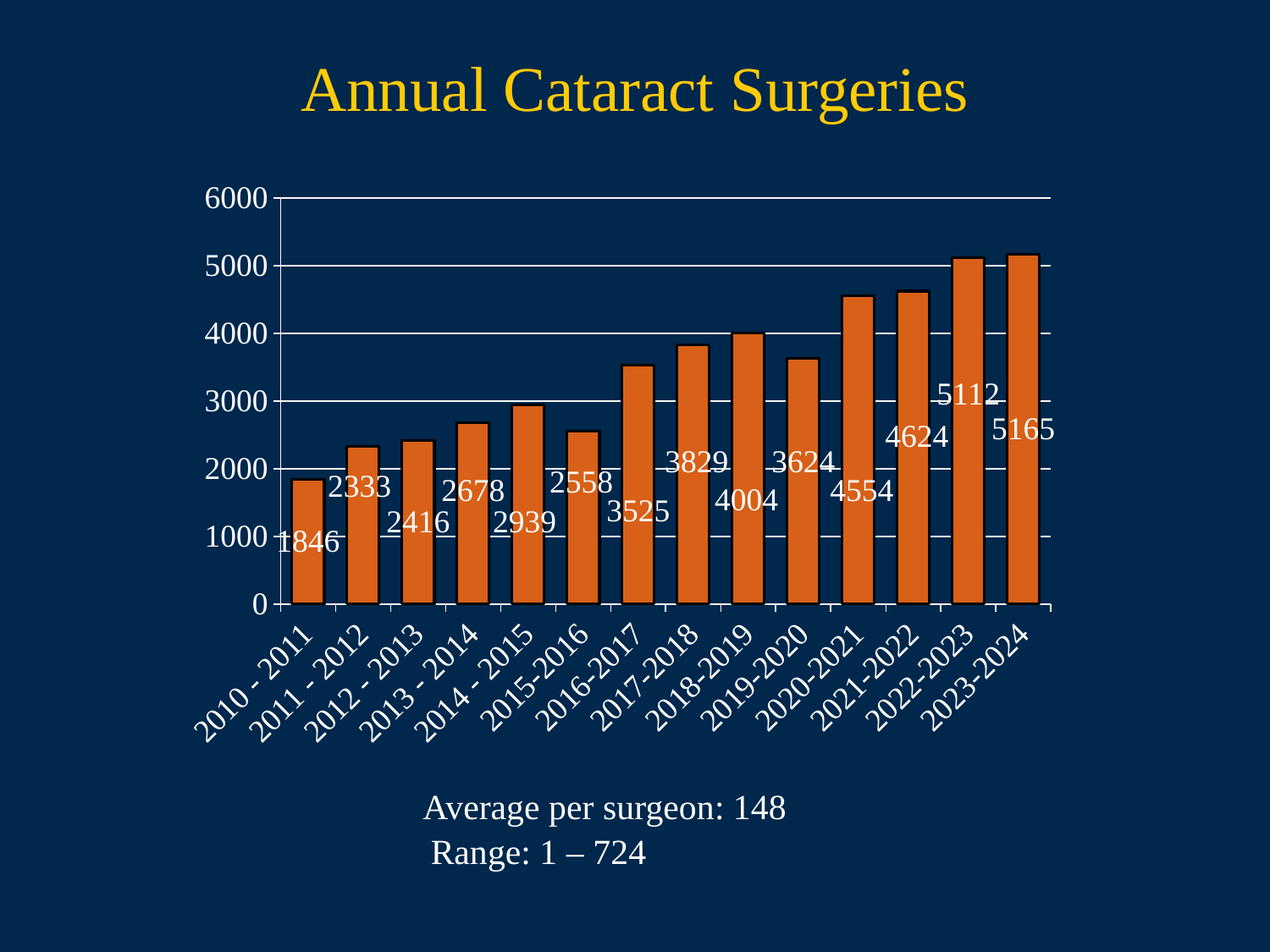
Is the value for 2016-2017 greater or less than 3000? greater Which year has the lowest number of cataract surgeries? 2010 - 2011 What is the value for 2018-2019? 4004 What is the title of the chart? Annual Cataract Surgeries What is the difference between the values for 2019-2020 and 2018-2019? 380 Which year has the highest number of cataract surgeries? 2023-2024 What is the value for 2023-2024? 5165 What is the value for 2010 - 2011? 1846 How many years are shown on the x axis? 14 Which is larger, the value for 2015-2016 or the value for 2014 - 2015? 2014 - 2015 What is the difference between the values for 2023-2024 and 2010 - 2011? 3319 What kind of chart is shown on the slide? bar chart